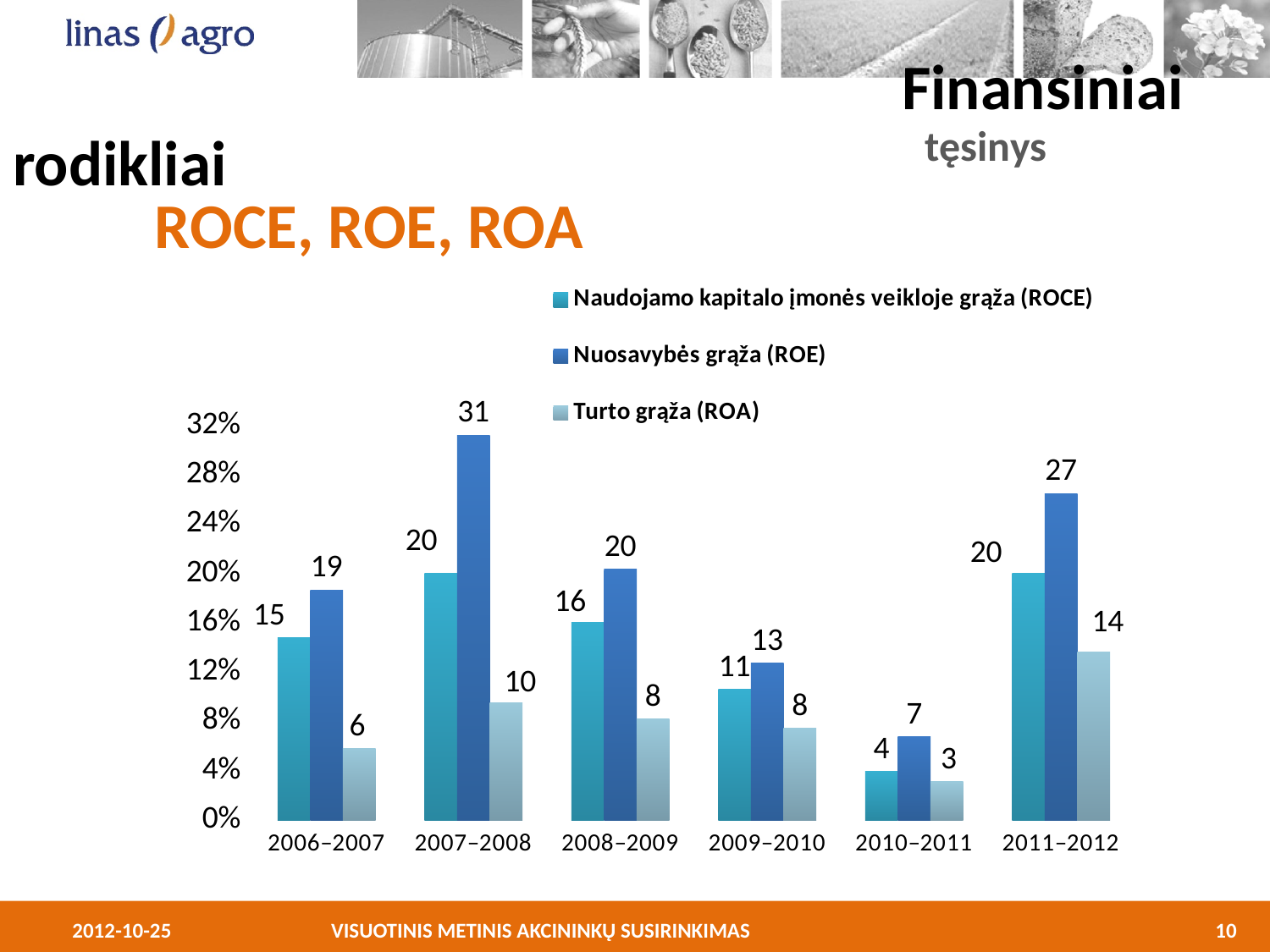
Does Nuosavybės grąža (ROE) rise or fall from 2007–2008 to 2010–2011? Fall Which is larger in 2008–2009: ROCE or ROE? ROE How many periods are shown on the x axis? 6 In which period is Nuosavybės grąža (ROE) highest? 2007–2008 What is the value of Turto grąža (ROA) for 2011–2012? 14 What is the value of Nuosavybės grąža (ROE) for 2007–2008? 31 What kind of chart is shown on the slide? Bar chart What is the value of Naudojamo kapitalo įmonės veikloje grąža (ROCE) for 2010–2011? 4 In which period is Turto grąža (ROA) lowest? 2010–2011 How many series does the legend list? 3 What is the title of the chart? ROCE, ROE, ROA What is the difference between ROE and ROCE in 2011–2012? 7